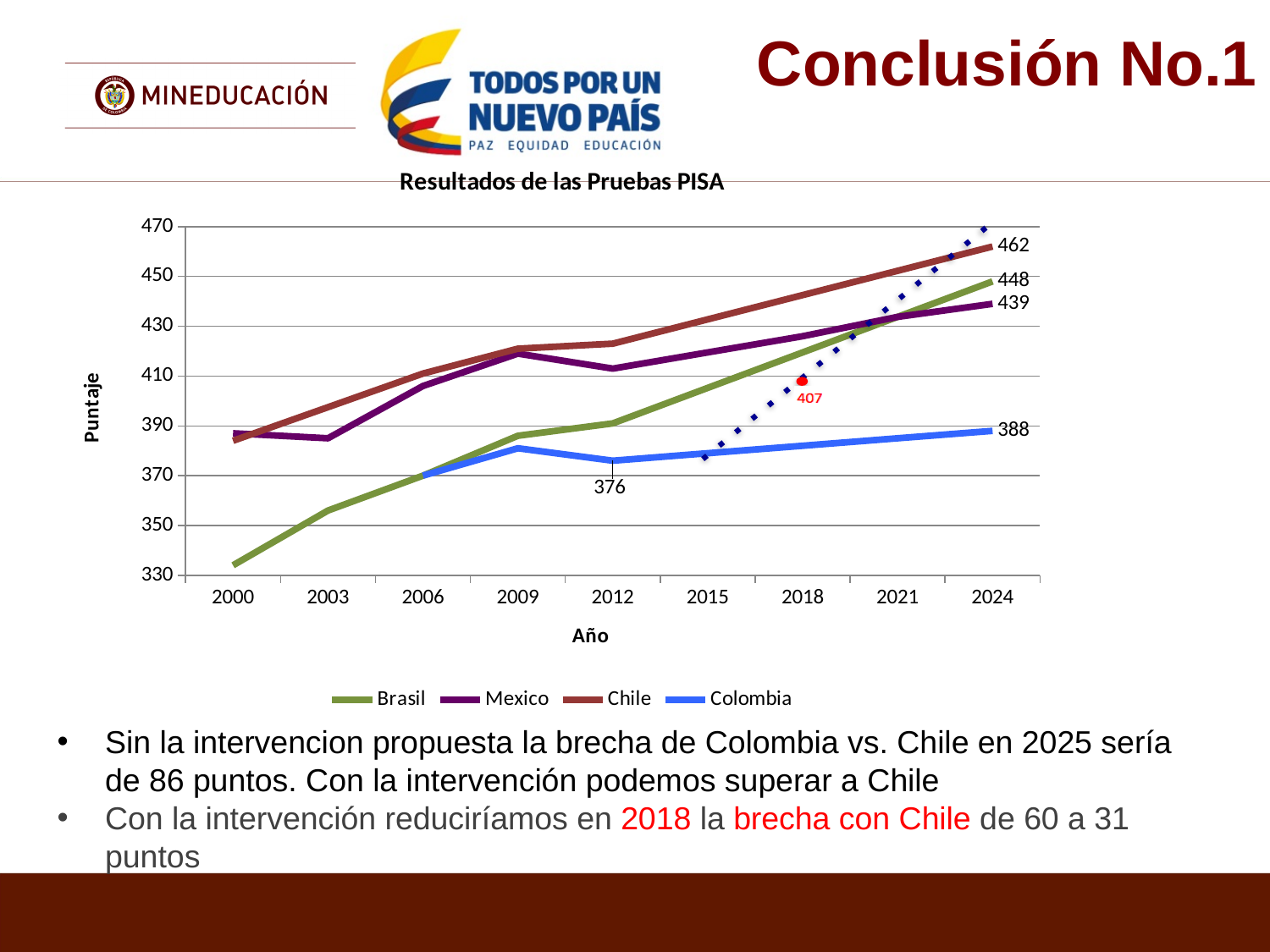
How many series does the legend list? 4 Which country has the lowest value in 2024? Colombia What is the value for Colombia in 2012? 376 Is the value for Brasil in 2000 greater or less than 350? less What is the value for Colombia in 2024? 388 Which country has the highest value in 2024? Chile What is the title of the chart? Resultados de las Pruebas PISA What is the value for Brasil in 2024? 448 What kind of chart is shown on the slide? line chart What is the difference between the 2024 values for Chile and Colombia? 74 What is the value for Chile in 2024? 462 What is the value for Mexico in 2024? 439